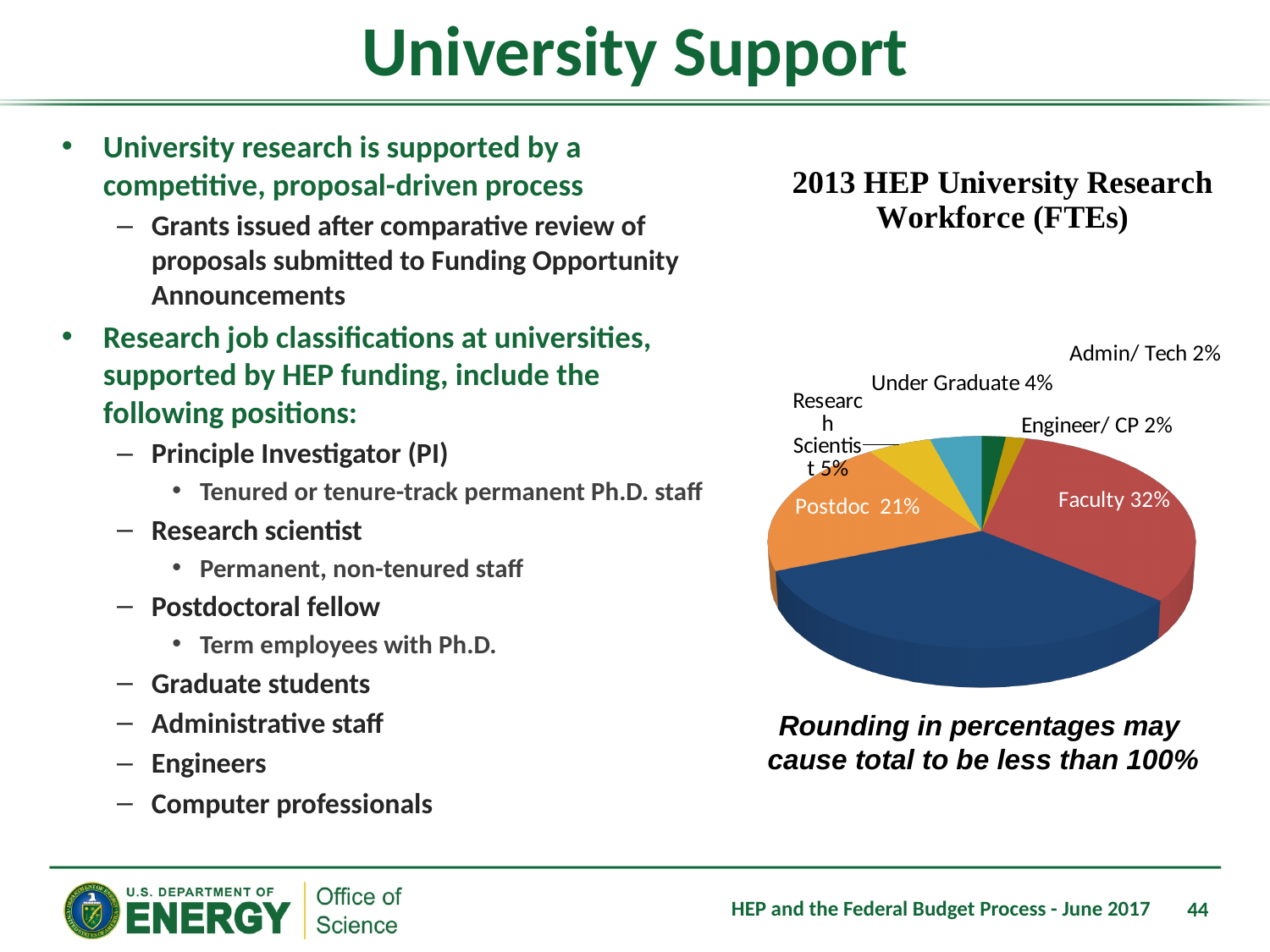
How many percentage points larger is the Faculty share than the Postdoc share? 11 What share of the 2013 HEP University Research Workforce is Admin/ Tech? 2% What is the title of the chart? 2013 HEP University Research Workforce (FTEs) What share of the 2013 HEP University Research Workforce is Research Scientist? 5% What share of the 2013 HEP University Research Workforce is Under Graduate? 4% What share of the 2013 HEP University Research Workforce is Engineer/ CP? 2% What type of chart is shown on the slide? Pie chart What share of the 2013 HEP University Research Workforce is Postdoc? 21% What share of the 2013 HEP University Research Workforce is Faculty? 32% How many percentage points larger is the Postdoc share than the Research Scientist share? 16 Which has the larger share of the workforce, Faculty or Postdoc? Faculty According to the note below the chart, why might the percentages total less than 100%? Rounding in percentages